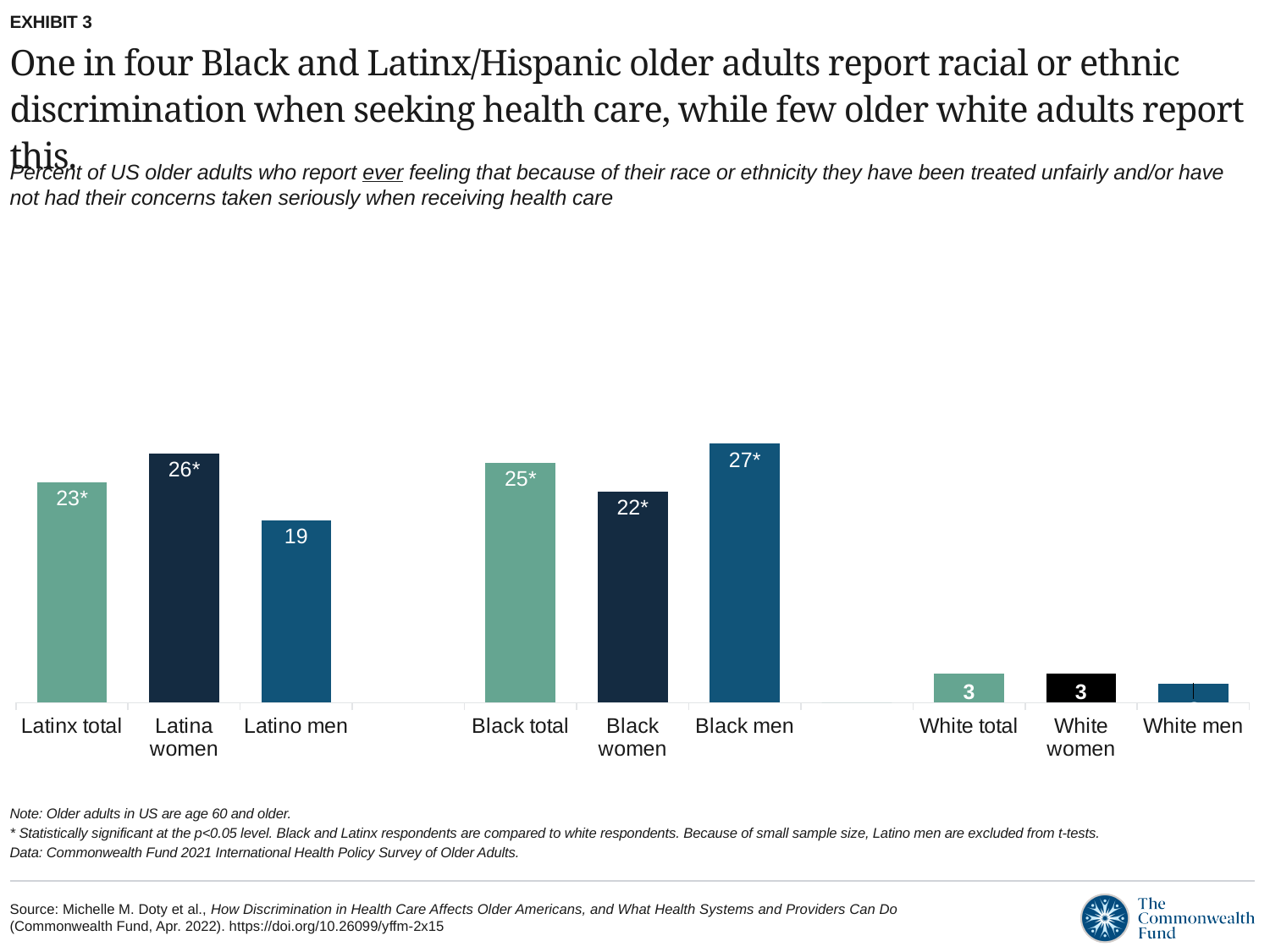
How many categories are shown on the x axis of the chart? 9 What value is shown for Latina women? 26* What is the difference between the values for Latina women and Latino men? 7 What exhibit number is given at the top of the slide? Exhibit 3 What value is shown for White total? 3 What value is shown for Black total? 25* Which category has the highest value in the chart? Black men Among the three Latinx/Hispanic categories, which has the lowest value? Latino men What kind of chart is shown on the slide? Bar chart Which is larger, the value for Black total or the value for Latinx total? Black total What is the difference between the values for Black men and Black women? 5 What value is shown for Latino men? 19